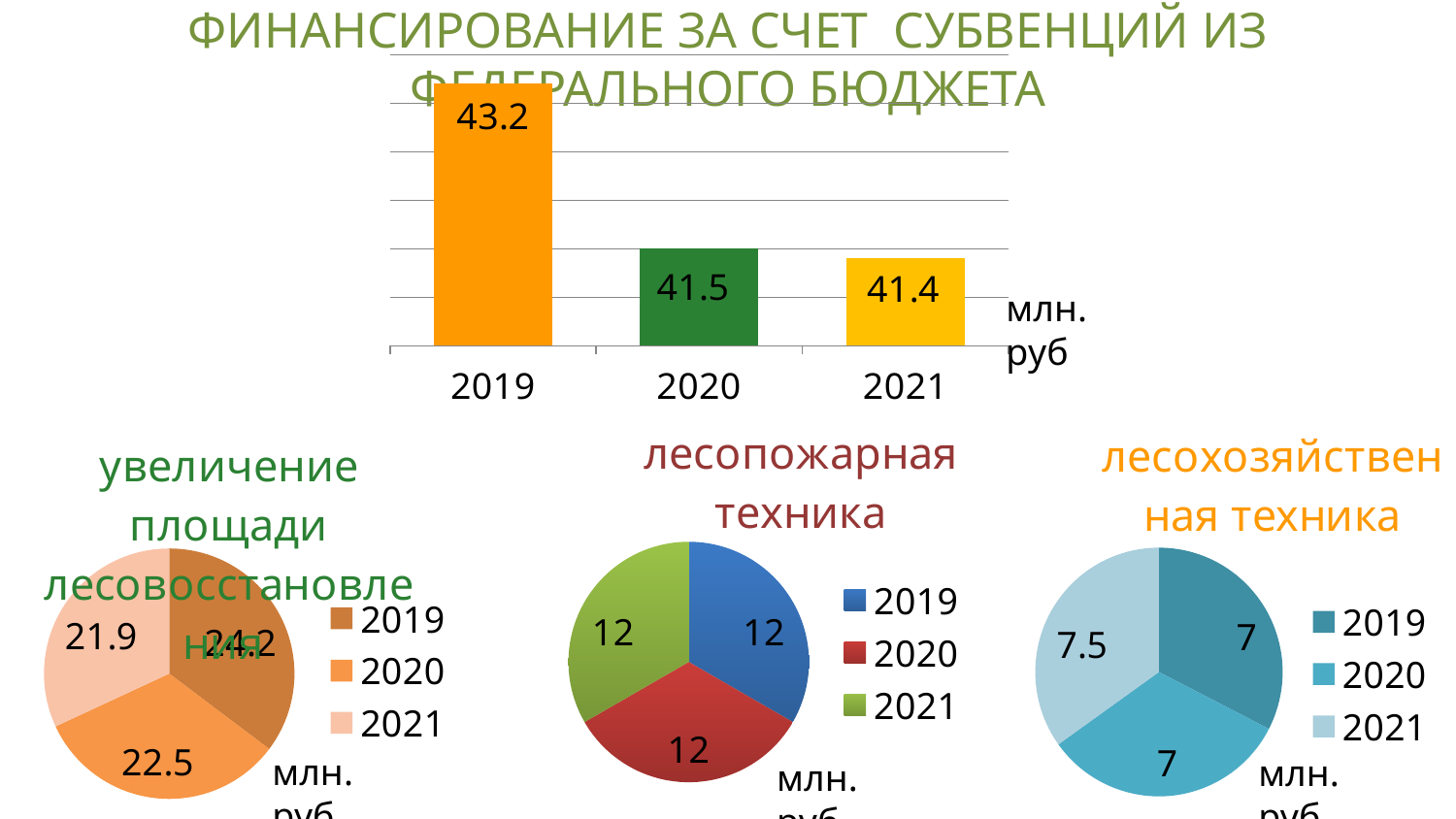
In the top bar chart, what is the value for 2021? 41.4 In the pie chart 'увеличение площади лесовосстановления', which year has the smallest slice? 2021 How many entries does the legend of the pie chart 'лесохозяйственная техника' list? 3 In the top bar chart, which year has the highest value? 2019 In the pie chart 'увеличение площади лесовосстановления', what is the value for 2020? 22.5 How many bars are in the top bar chart? 3 What type of chart is the top chart titled 'ФИНАНСИРОВАНИЕ ЗА СЧЕТ СУБВЕНЦИЙ ИЗ ФЕДЕРАЛЬНОГО БЮДЖЕТА'? bar chart In the top bar chart, what is the difference between the values for 2019 and 2020? 1.7 In the top bar chart, what is the value for 2019? 43.2 In the pie chart 'лесопожарная техника', what is the value for 2019? 12 In the top bar chart, do the values rise or fall from 2019 to 2021? fall In the pie chart 'лесохозяйственная техника', what is the value for 2021? 7.5